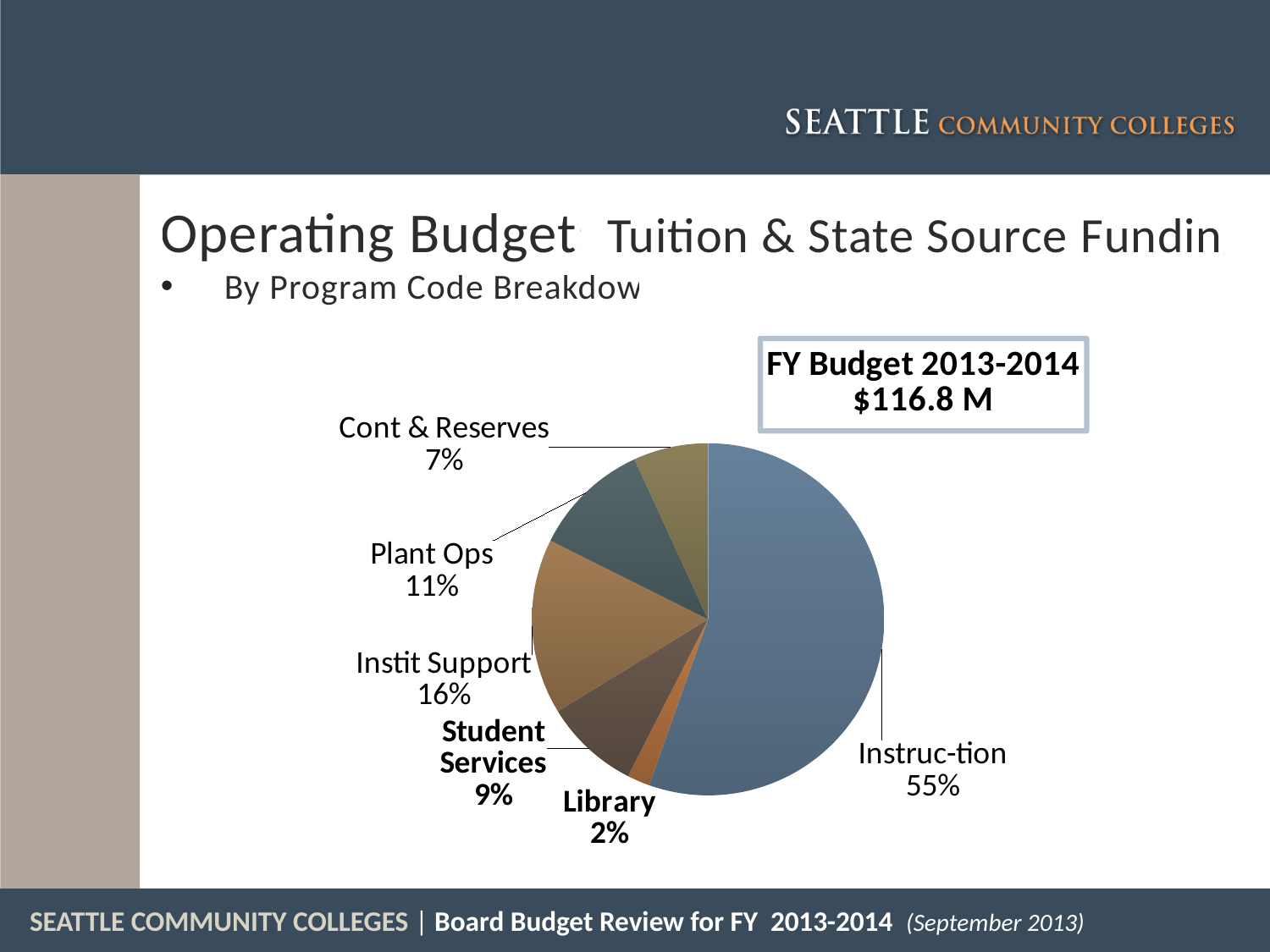
Which category has the smallest slice of the pie? Library What is the difference in percentage points between Instit Support and Student Services? 7 Which category has the largest slice of the pie? Instruction How many slices does the pie chart have? 6 What percentage is shown for Library? 2% What percentage is shown for Instit Support? 16% What percentage is shown for Plant Ops? 11% What kind of chart is shown on the slide? pie chart What share of the pie does Instruction represent? 55% What total budget amount is shown in the box on the chart? $116.8 M What fiscal year does the chart's budget box refer to? 2013-2014 Which is larger, Plant Ops or Cont & Reserves? Plant Ops